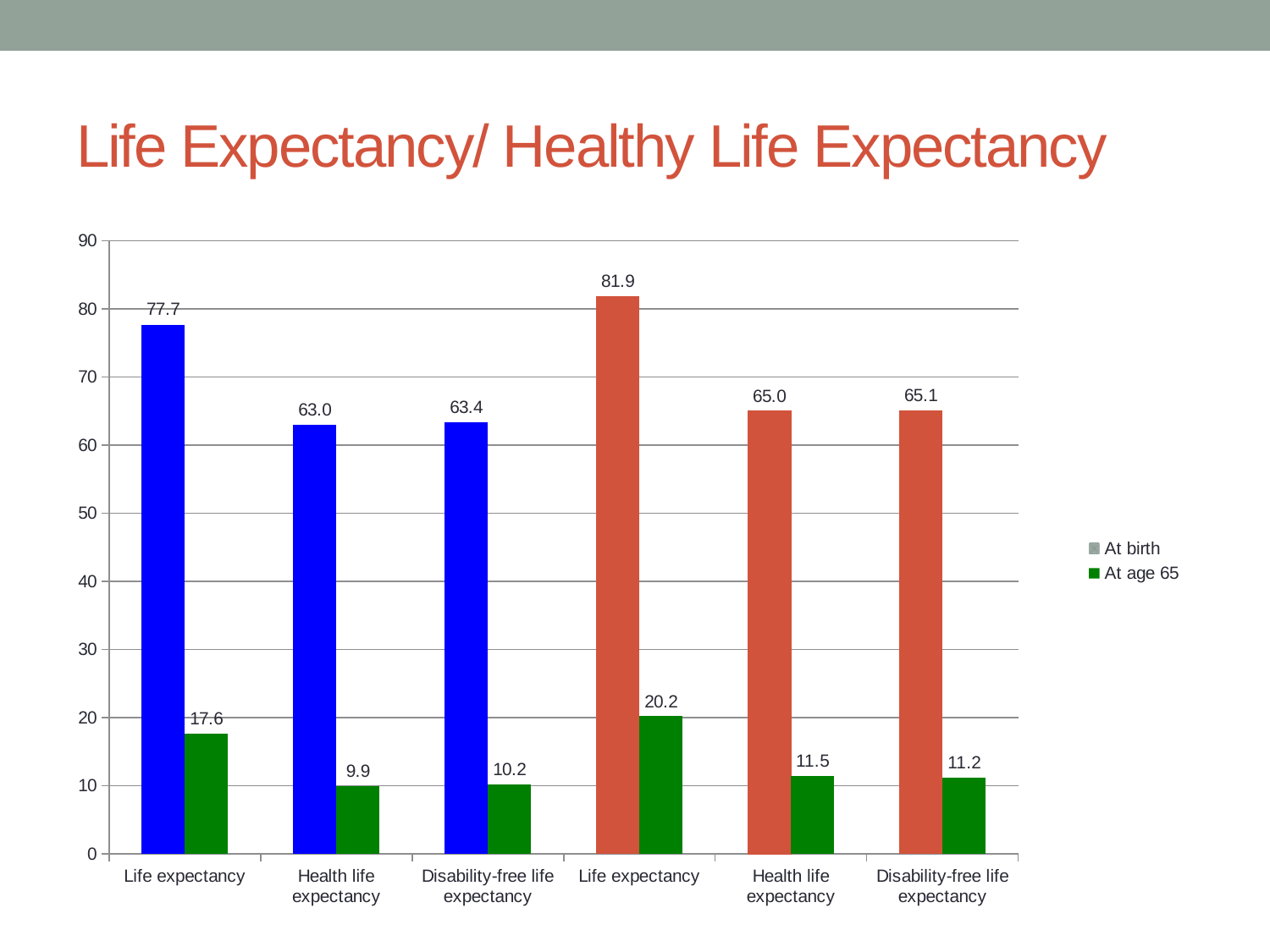
What is the difference between the 'At birth' values of the two 'Life expectancy' categories (81.9 and 77.7)? 4.2 What is the 'At birth' value for the first (leftmost) 'Life expectancy' category? 77.7 What type of chart is shown on the slide? Bar chart Is the 'At birth' value for 'Disability-free life expectancy' in the left-hand group greater or less than 60? greater How many series does the legend list? 2 How many categories are shown on the x axis? 6 Which category has the lowest 'At age 65' value? Health life expectancy (left-hand group, 9.9) What is the 'At age 65' value for the 'Life expectancy' category in the right-hand (red) group? 20.2 What is the 'At age 65' value for 'Disability-free life expectancy' in the right-hand (red) group? 11.2 What is the 'At birth' value for 'Health life expectancy' in the left-hand (blue) group? 63.0 Which category has the highest 'At birth' value? Life expectancy (right-hand group, 81.9) Which is larger: the 'At age 65' value for 'Health life expectancy' in the right-hand group or for 'Disability-free life expectancy' in the right-hand group? Health life expectancy (11.5)